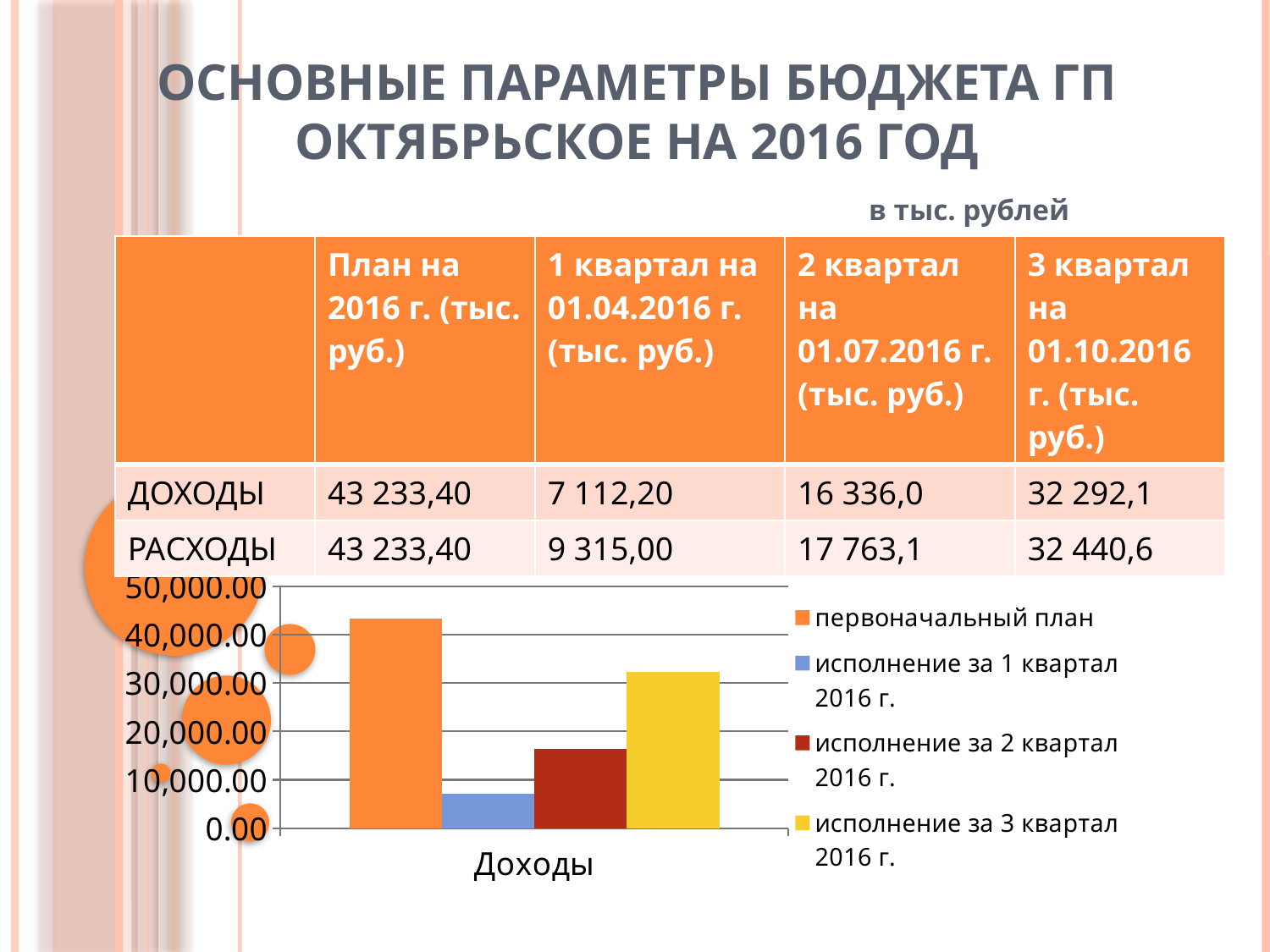
Is the value for исполнение за 1 квартал 2016 г. greater or less than 10,000.00? less How many categories are shown on the x axis of the chart? 1 How many series does the chart legend list? 4 Is the value for исполнение за 2 квартал 2016 г. greater or less than 20,000.00? less What is the category label on the x axis of the chart? Доходы Which series has the shortest bar in the chart? исполнение за 1 квартал 2016 г. What colour is the bar for исполнение за 3 квартал 2016 г.? yellow Is the value for первоначальный план greater or less than 40,000.00? greater Which series has the tallest bar in the chart? первоначальный план What kind of chart is shown on the slide? bar chart Which is larger in the chart: исполнение за 2 квартал 2016 г. or исполнение за 3 квартал 2016 г.? исполнение за 3 квартал 2016 г.